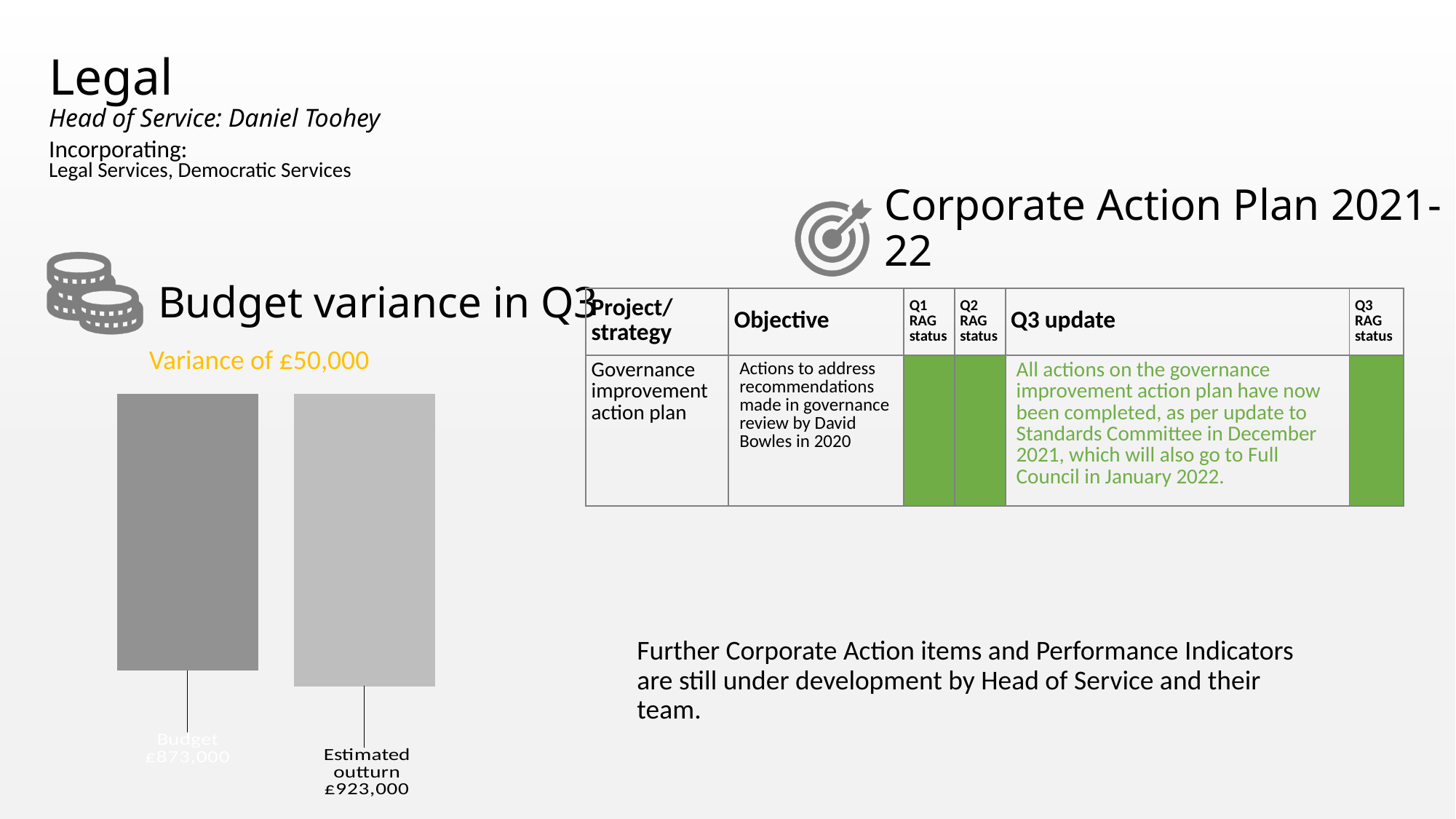
What variance amount is stated above the Budget variance in Q3 chart? Variance of £50,000 How many bars are shown in the Budget variance in Q3 chart? 2 What is the value of the Estimated outturn bar in the Budget variance in Q3 chart? £923,000 What is the value of the Budget bar in the Budget variance in Q3 chart? £873,000 What type of chart is used to show the Budget variance in Q3? bar chart Which bar in the Budget variance in Q3 chart has the higher value? Estimated outturn What is the title of the chart on the left of the slide? Budget variance in Q3 Which bar in the Budget variance in Q3 chart has the lower value? Budget Is the Budget value larger or smaller than the Estimated outturn value in the Budget variance in Q3 chart? smaller What is the difference between the Estimated outturn and the Budget in the Budget variance in Q3 chart? £50,000